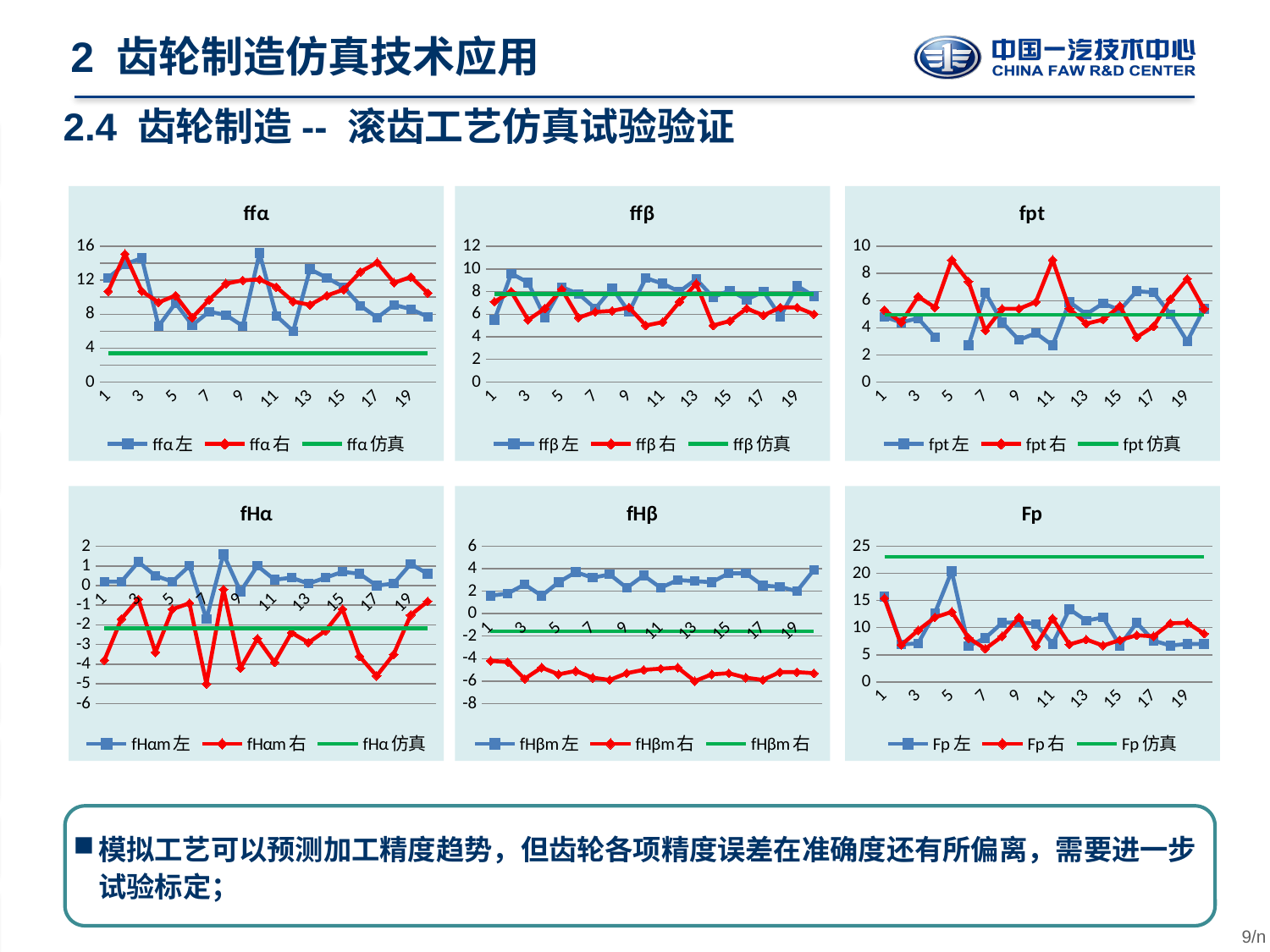
In the ffα chart, is the ffα 仿真 line greater or less than 4? less In the fHα chart, is the value of fHαm 右 at point 7 greater or less than -4? less How many series does the legend of the Fp chart list? 3 What are the legend entries of the ffα chart? ffα 左, ffα 右, ffα 仿真 In the fpt chart, is the fpt 仿真 line greater or less than 6? less In the fHβ chart, which series has the higher values, fHβm 左 or fHβm 右? fHβm 左 What kind of chart is the ffα chart? line chart How many charts are shown on the slide? 6